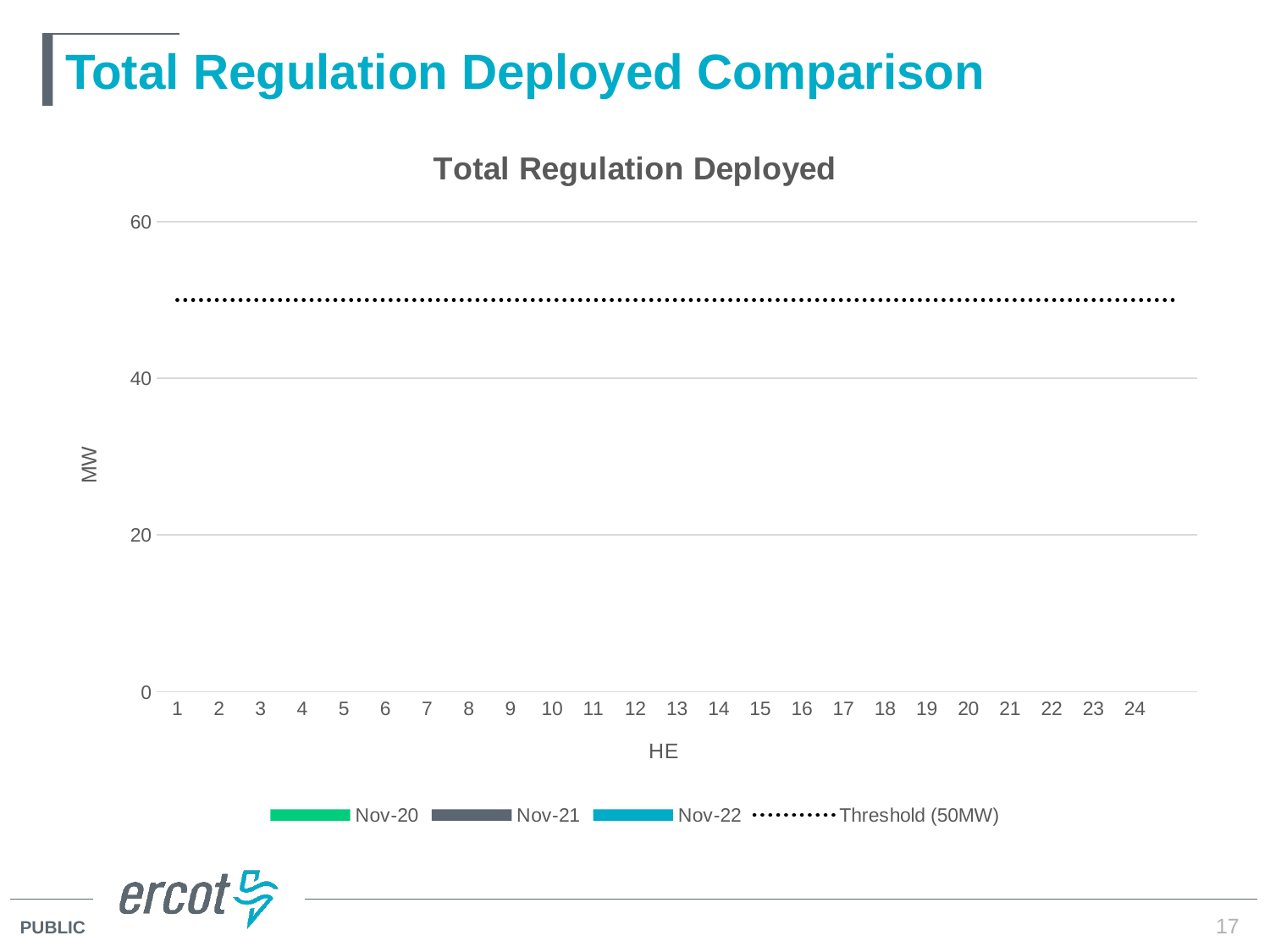
Is the Threshold line above or below the 40 gridline on the y axis? above At what MW level is the dotted Threshold line drawn? 50MW Which legend entry is shown as a dotted line rather than a solid bar swatch? Threshold (50MW) How many entries does the chart legend list? 4 How many hour-ending (HE) categories are shown on the x axis? 24 What is the title of the chart? Total Regulation Deployed What is the label of the y axis? MW